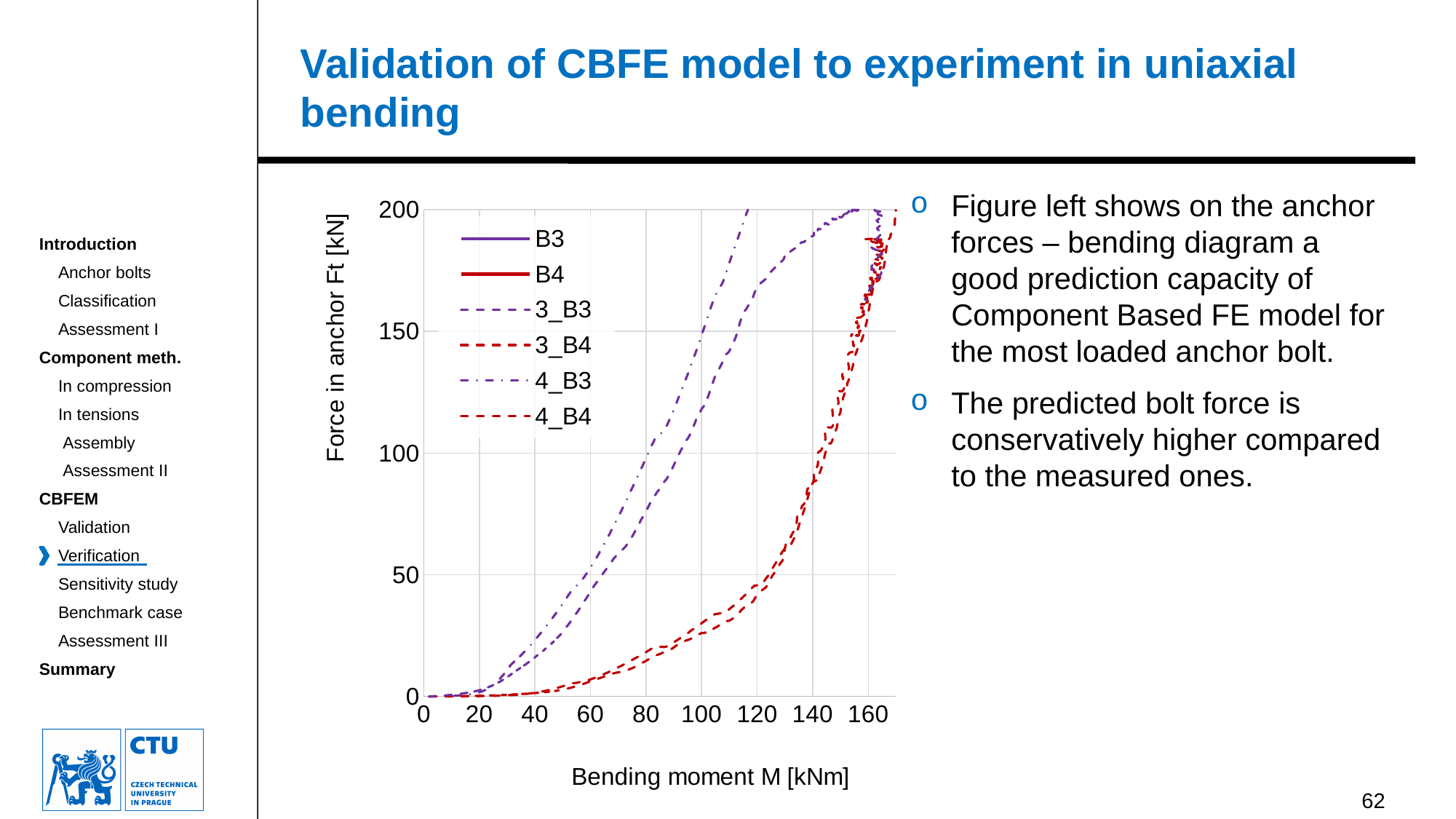
What is the label of the y axis of the chart? Force in anchor Ft [kN] Which series reaches 200 kN at the lowest bending moment? 4_B3 Is the value of the 3_B3 series at a bending moment of 100 kNm greater or less than 100 kN? greater Does the force in the anchor rise or fall as the bending moment increases along the x axis? rise Is the value of the 4_B3 series at a bending moment of 120 kNm greater or less than 150 kN? greater Is the value of the 4_B4 series at a bending moment of 100 kNm greater or less than 50 kN? less What kind of chart is shown on the slide? line chart What is the label of the x axis of the chart? Bending moment M [kNm] How many series does the chart legend list? 6 At a bending moment of 100 kNm, which series has the larger force: 3_B3 or 3_B4? 3_B3